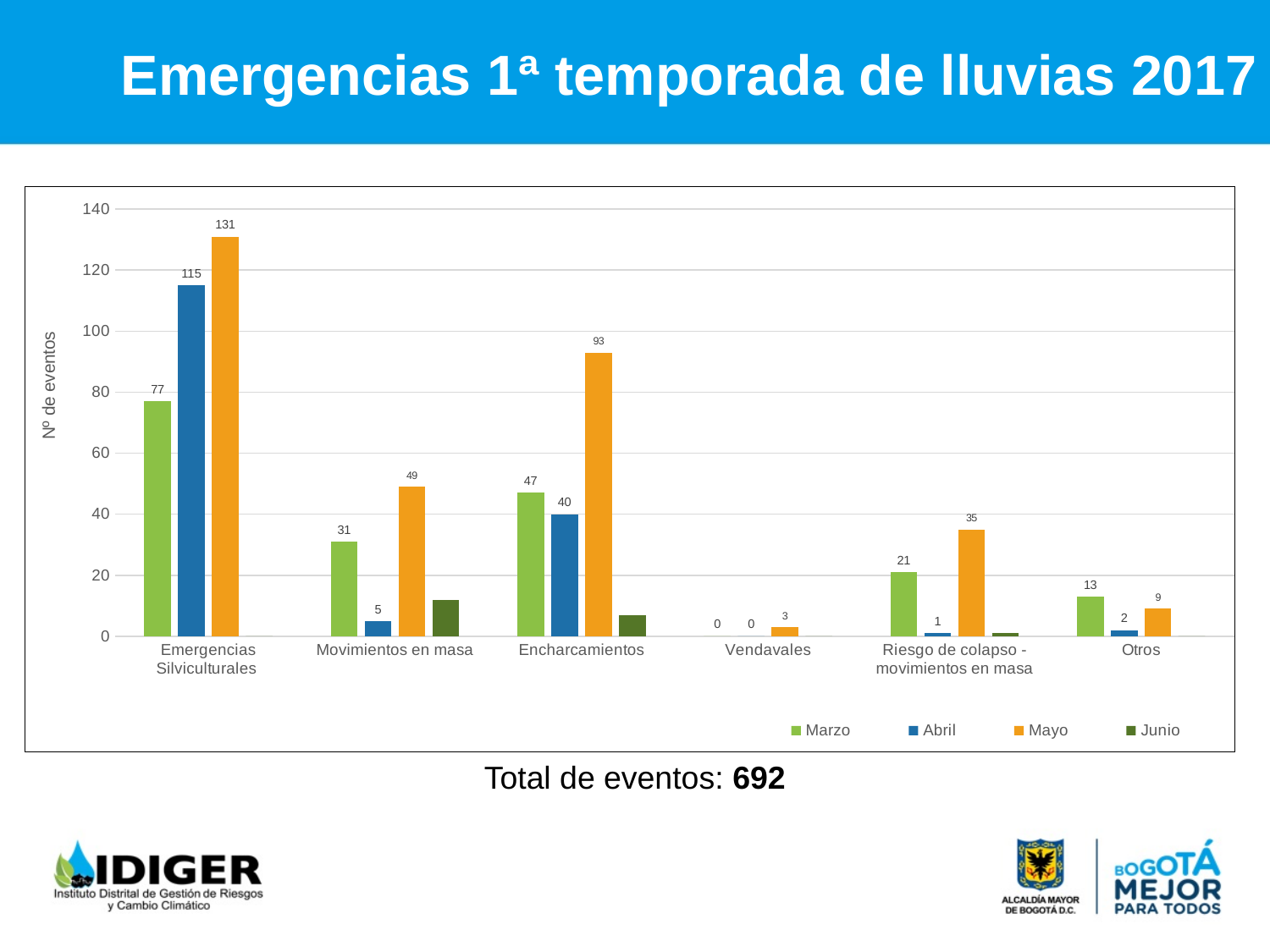
Which category has the highest value for the Mayo series? Emergencias Silviculturales What is the label of the y axis? Nº de eventos Which category has the lowest value for the Marzo series? Vendavales What is the value for Abril in the Encharcamientos category? 40 Is the value for Junio in the Movimientos en masa category greater or less than 20? less What kind of chart is shown on the slide? bar chart Which is larger for Otros: the Marzo value or the Mayo value? Marzo How many series does the legend list? 4 What is the value for Marzo in the Riesgo de colapso - movimientos en masa category? 21 What is the difference between the Mayo and Marzo values for Encharcamientos? 46 What is the value for Mayo in the Emergencias Silviculturales category? 131 How many categories are shown on the x axis? 6